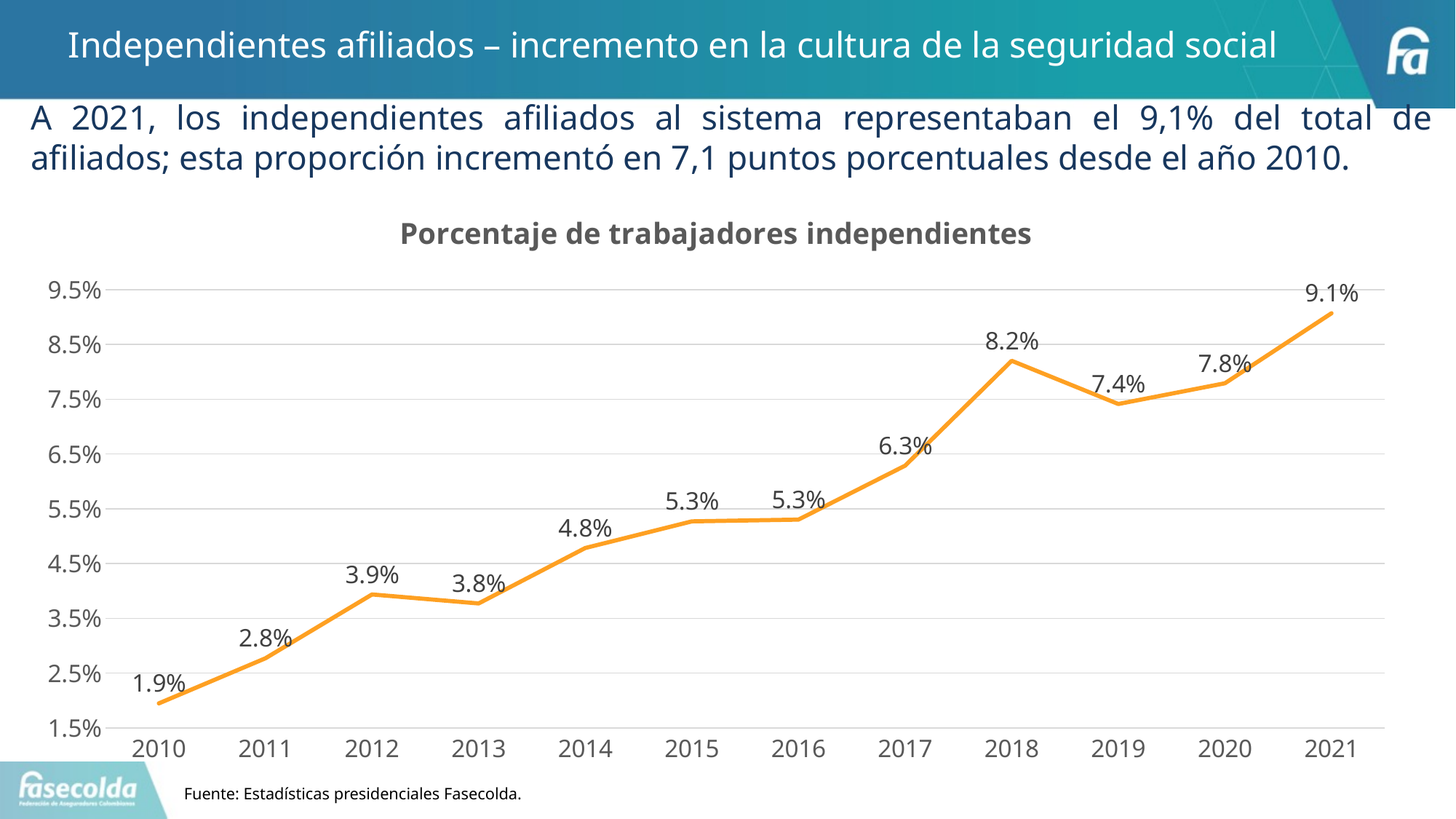
Which year has the lowest value? 2010 Is the value for 2017 greater or less than 5.5%? greater What is the title of the chart? Porcentaje de trabajadores independientes What is the value for 2010? 1.9% Which is larger, the value for 2018 or the value for 2019? 2018 What is the difference between the values for 2021 and 2010? 7.2 percentage points What kind of chart is shown? line chart Which year has the highest value? 2021 Do the values generally rise or fall from 2010 to 2021? rise What is the value for 2021? 9.1% What is the value for 2018? 8.2% How many years are plotted on the x axis? 12